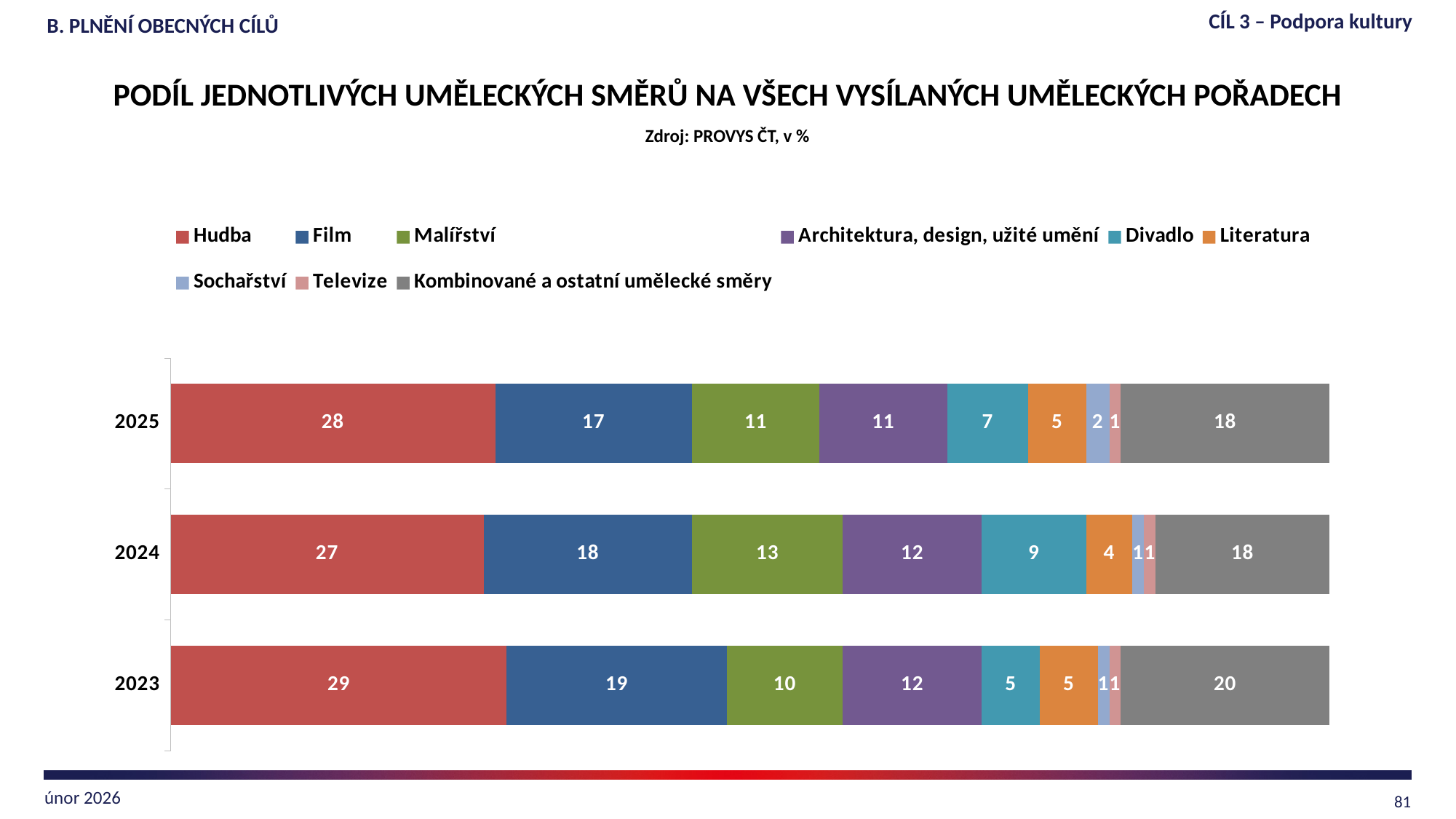
What is the source stated under the chart title? PROVYS ČT, v % What is the difference between the Malířství values in 2024 and 2023? 3 Which is larger in 2025: the value for Film or the value for Kombinované a ostatní umělecké směry? Kombinované a ostatní umělecké směry What is the value for Hudba in 2025? 28 How many series does the legend list? 9 How many years (categories) are shown on the chart? 3 What is the value for Divadlo in 2024? 9 What kind of chart is shown on the slide? stacked bar chart In which year is the value for Divadlo the lowest? 2023 In which year is the value for Hudba the highest? 2023 What is the value for Film in 2023? 19 What is the value for Kombinované a ostatní umělecké směry in 2023? 20